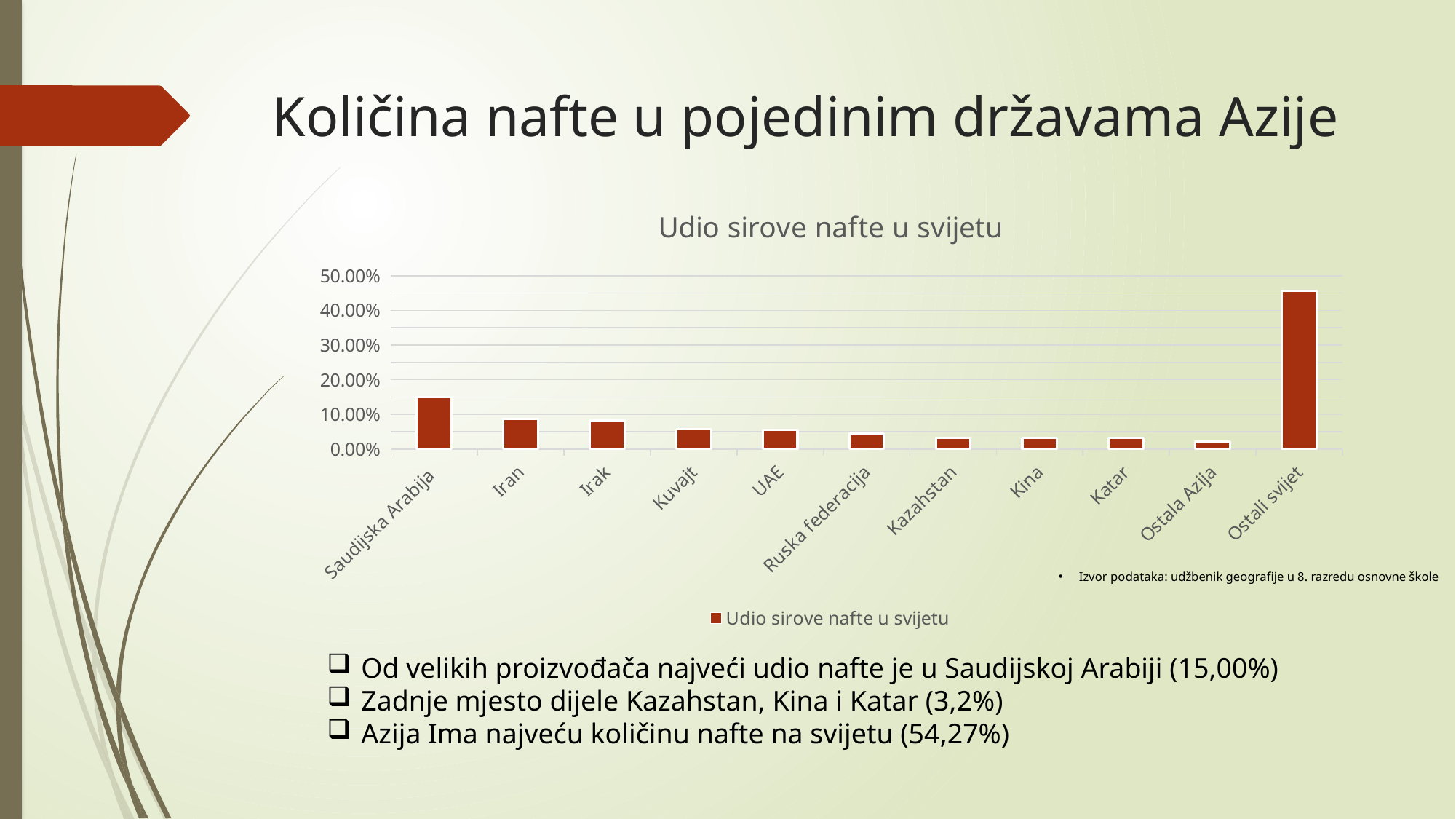
What is the legend entry shown below the chart? Udio sirove nafte u svijetu Which category has the lowest value in the chart? Ostala Azija Which has a larger value, Saudijska Arabija or Iran? Saudijska Arabija How many categories are shown on the x axis of the chart? 11 Which category has the highest value in the chart? Ostali svijet Is the value for Ostali svijet greater or less than 40.00%? greater What kind of chart is shown on the slide? bar chart What is the title of the chart? Udio sirove nafte u svijetu Is the value for Kuvajt greater or less than 10.00%? less Is the value for Saudijska Arabija greater or less than 10.00%? greater How many series does the chart legend list? 1 Do the values rise or fall along the x axis from Saudijska Arabija to Ostala Azija? fall